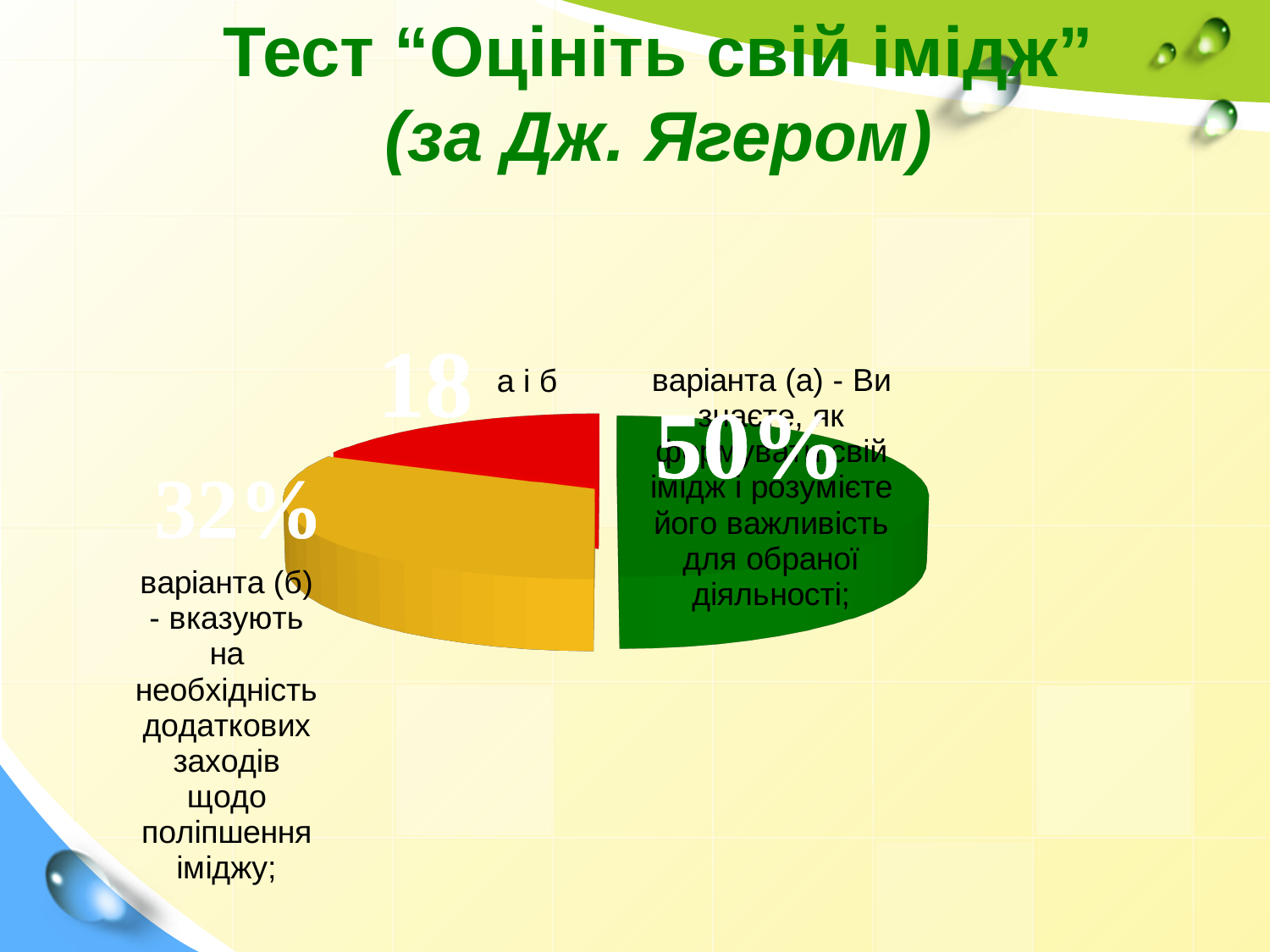
Which slice of the pie chart is the smallest? а і б What colour is the slice for варіанта (б)? yellow How many slices does the pie chart have? 3 What kind of chart is shown on the slide? pie chart What value is labelled on the slice for а і б? 18 What colour is the slice for варіанта (а)? green What percentage is shown for варіанта (а)? 50% What share of the pie does варіанта (а) take? 50% What is the difference between the percentages for варіанта (а) and варіанта (б)? 18% Which is larger, the slice for варіанта (а) or the slice for варіанта (б)? варіанта (а) What percentage is shown for варіанта (б)? 32% Which slice of the pie chart is the largest? варіанта (а)